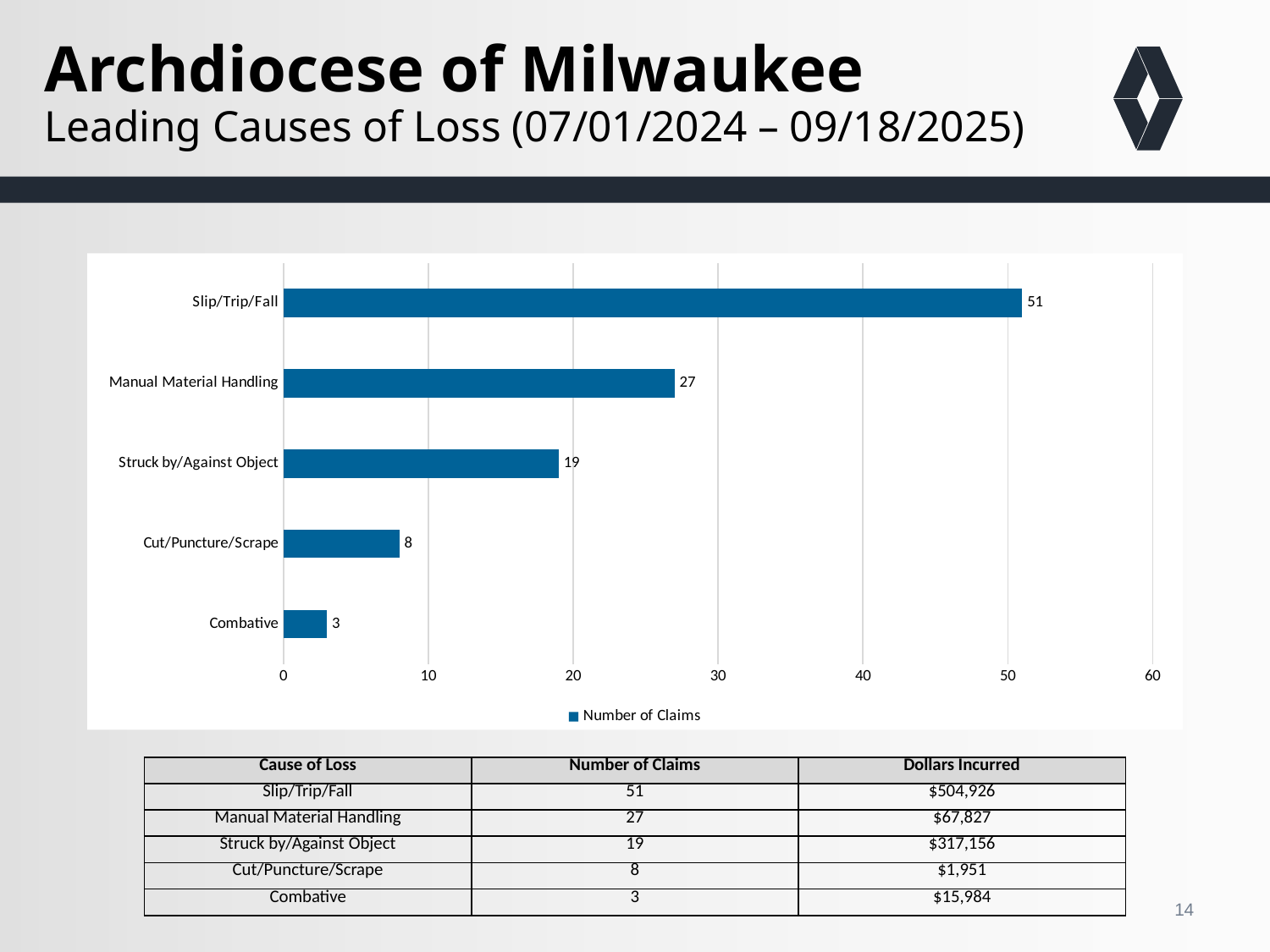
Which has more claims, Manual Material Handling or Struck by/Against Object? Manual Material Handling What is the number of claims for Struck by/Against Object? 19 Which cause of loss has the lowest number of claims? Combative What is the difference in number of claims between Slip/Trip/Fall and Manual Material Handling? 24 What type of chart is shown on the slide? bar chart How many causes of loss are shown in the chart? 5 What series name is shown in the chart legend? Number of Claims What is the number of claims for Combative? 3 Which cause of loss has the highest number of claims? Slip/Trip/Fall Is the number of claims for Manual Material Handling greater or less than 30? less What is the number of claims for Slip/Trip/Fall? 51 What is the difference in number of claims between Cut/Puncture/Scrape and Combative? 5